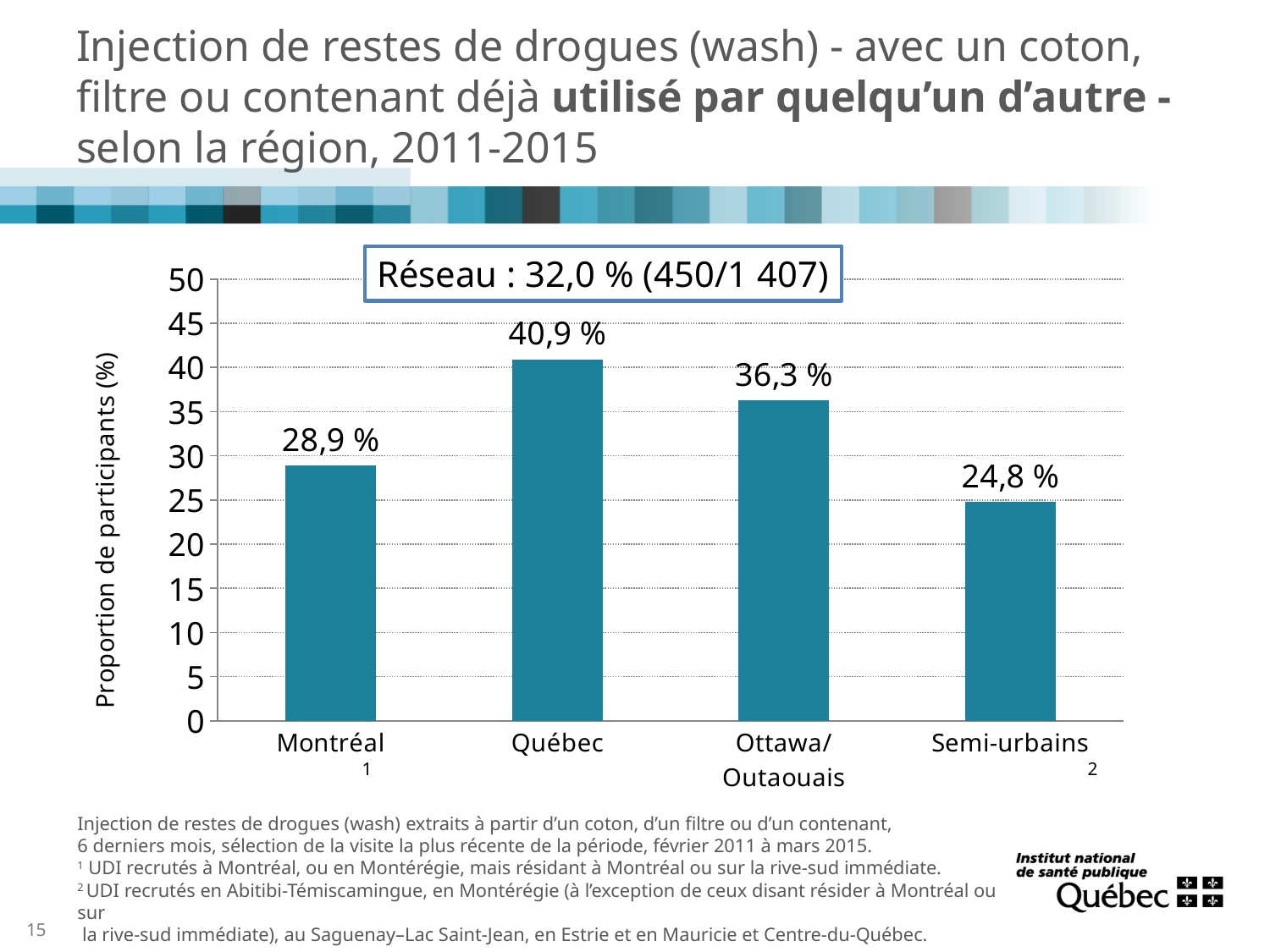
What is the value for Québec? 40,9 % Which region has the lowest proportion? Semi-urbains What is the overall network (Réseau) proportion shown in the box above the chart? 32,0 % (450/1 407) Which is larger, the value for Montréal or the value for Ottawa/Outaouais? Ottawa/Outaouais What is the value for Montréal? 28,9 % How many regions are shown on the x axis? 4 Which region has the highest proportion? Québec What kind of chart is this? bar chart What is the difference between the values for Québec and Semi-urbains? 16,1 % Is the value for Montréal greater or less than 30? less What is the value for Semi-urbains? 24,8 % What is the value for Ottawa/Outaouais? 36,3 %